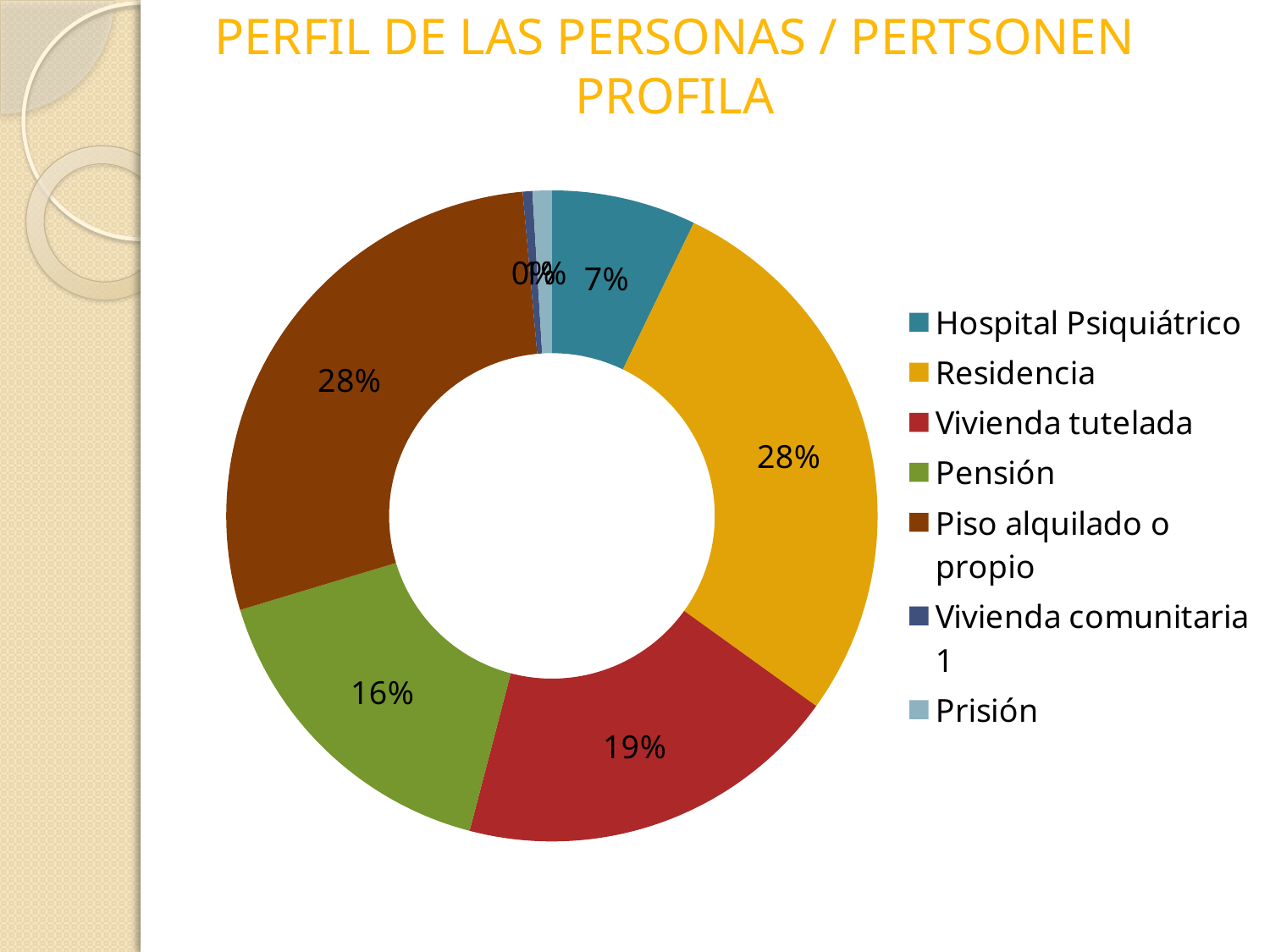
What colour represents Pensión in the chart? green What share of the chart does Residencia represent? 28% What percentage is shown for Hospital Psiquiátrico? 7% What percentage is shown for Pensión? 16% What percentage is shown for Vivienda tutelada? 19% What is the difference in percentage points between Vivienda tutelada and Pensión? 3 How many categories does the legend list? 7 What is the difference in percentage points between Residencia and Hospital Psiquiátrico? 21 What kind of chart is shown on the slide? doughnut chart Which is larger, the share for Hospital Psiquiátrico or the share for Residencia? Residencia What percentage is shown for Piso alquilado o propio? 28% Which is larger, the share for Vivienda tutelada or the share for Pensión? Vivienda tutelada